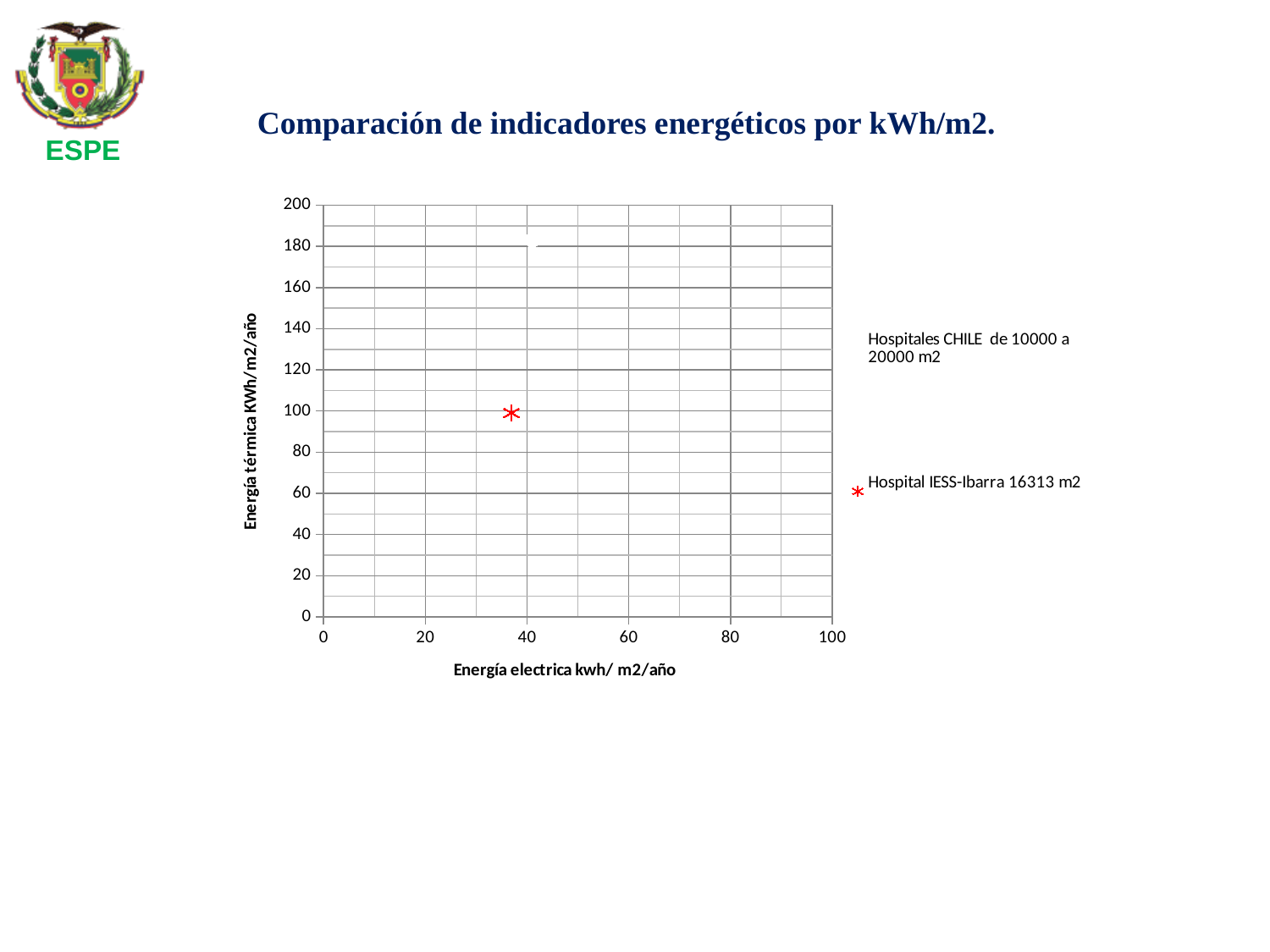
How many series does the legend list? 2 Is the thermal energy value (y axis) for Hospital IESS-Ibarra 16313 m2 greater or less than 80? greater Is the electrical energy value (x axis) for Hospital IESS-Ibarra 16313 m2 greater or less than 60? less Is the electrical energy value (x axis) for Hospital IESS-Ibarra 16313 m2 greater or less than 20? greater What is the label of the vertical axis? Energía térmica KWh/m2/año What kind of chart is shown on the slide? scatter chart What is the title of the chart? Comparación de indicadores energéticos por kWh/m2.